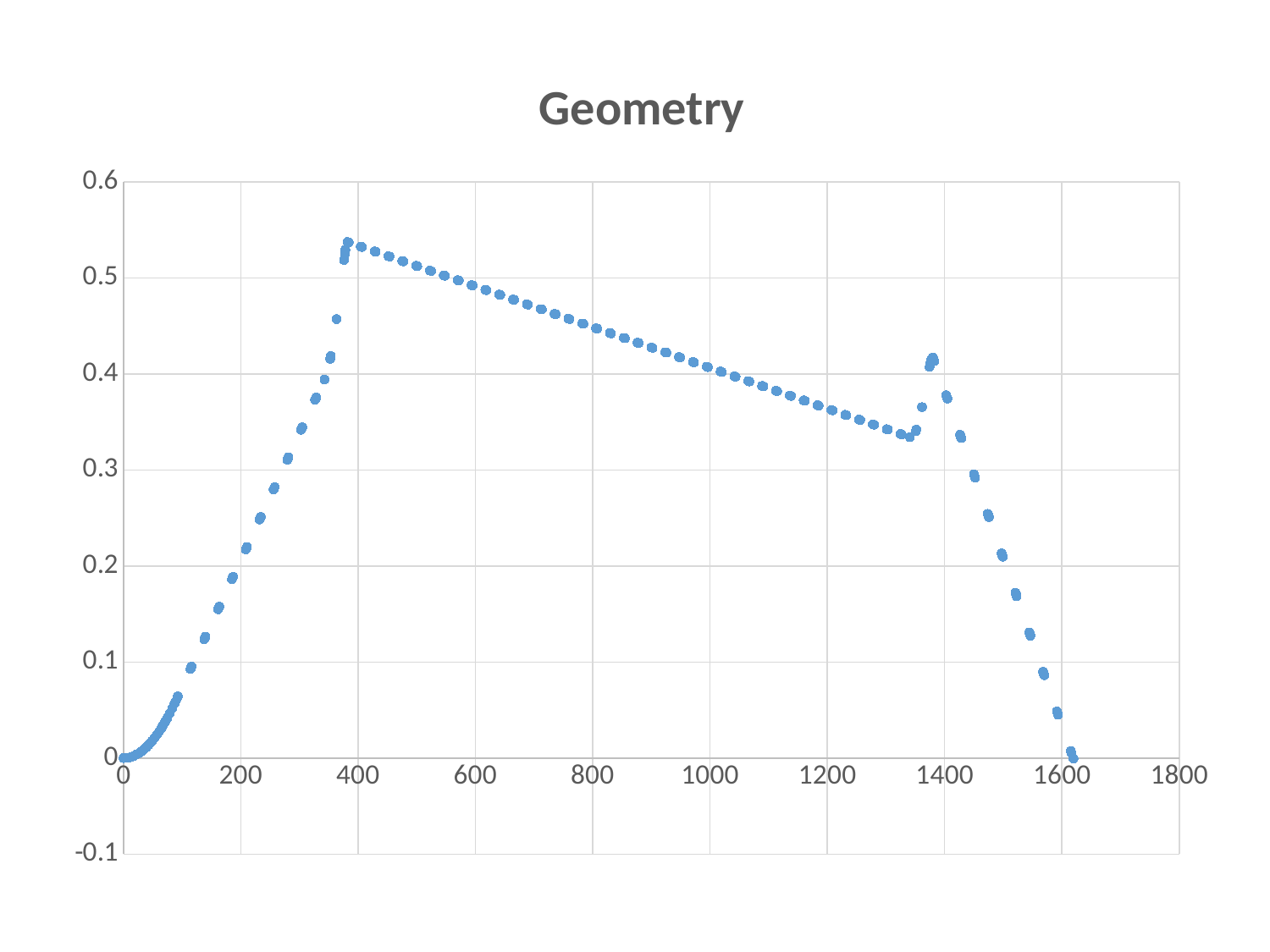
Is the value at x = 400 greater or less than 0.5? greater Is the value at x = 200 greater or less than 0.3? less What is the highest tick label shown on the x axis? 1800 Do the values rise or fall as x increases from 0 to 400? rise Do the values rise or fall as x increases from 400 to 1300? fall What kind of chart is shown on the slide? scatter chart Is the value at x = 1200 greater or less than 0.4? less Near which x-axis tick does the highest plotted value occur? 400 What is the title of the chart? Geometry